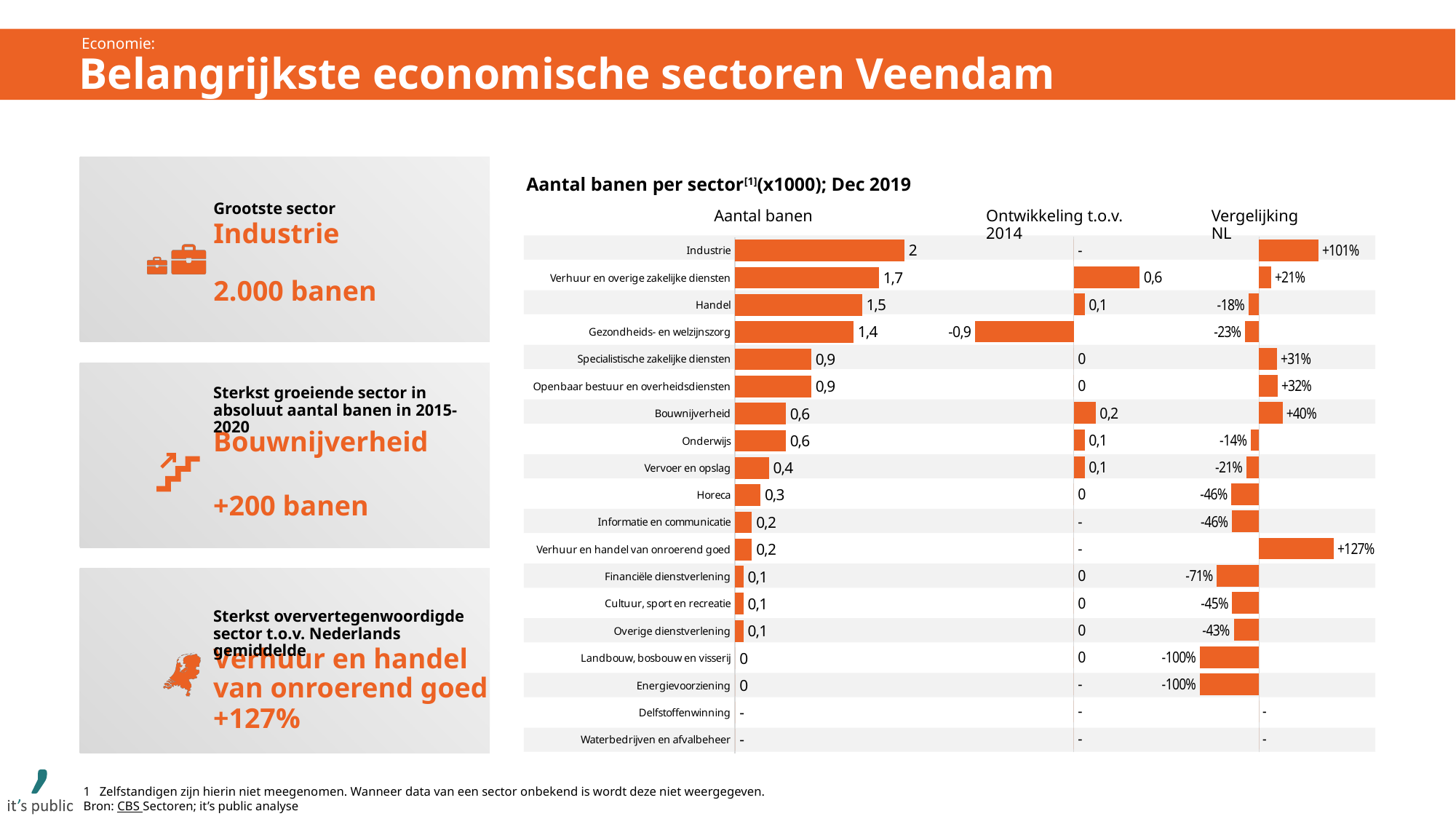
How many sectors are listed in the chart? 19 In the 'Aantal banen' column, what is the difference between Industrie and Verhuur en overige zakelijke diensten? 0,3 In the 'Ontwikkeling t.o.v. 2014' column, what is the value for Gezondheids- en welzijnszorg? -0,9 What is the title of the chart? Aantal banen per sector (x1000); Dec 2019 In the 'Aantal banen' column, which is larger: Handel or Gezondheids- en welzijnszorg? Handel Which sector has the highest value in the 'Aantal banen' column? Industrie In the 'Vergelijking NL' column, what is the value for Bouwnijverheid? +40% Which sector has the highest value in the 'Vergelijking NL' column? Verhuur en handel van onroerend goed What kind of chart is used to show the 'Aantal banen' values? Bar chart In the 'Aantal banen' column, what is the value for Handel? 1,5 Which sector has the lowest value in the 'Ontwikkeling t.o.v. 2014' column? Gezondheids- en welzijnszorg In the 'Vergelijking NL' column, which is larger: Specialistische zakelijke diensten or Openbaar bestuur en overheidsdiensten? Openbaar bestuur en overheidsdiensten